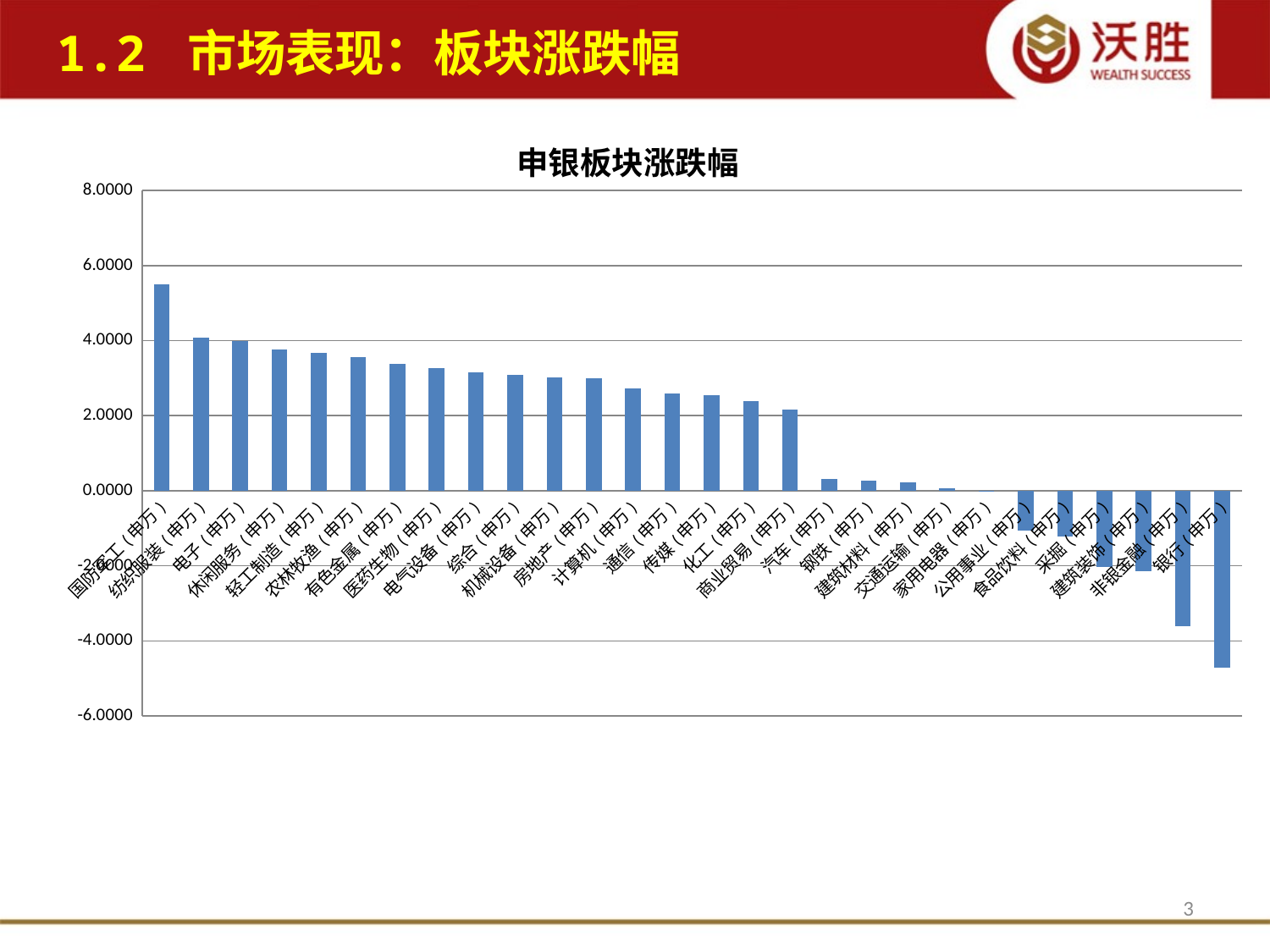
What is the title of the chart? 申银板块涨跌幅 Is the value for 国防军工（申万） greater or less than 4.0000? greater Which has the larger value, 国防军工（申万） or 纺织服装（申万）? 国防军工（申万） Which sector has the highest value in the chart? 国防军工（申万） Which sector has the lowest value in the chart? 银行（申万） Is the value for 非银金融（申万） greater or less than -2.0000? less Is the value for 休闲服务（申万） greater or less than 4.0000? less Do the values rise or fall moving from left to right along the x axis? fall How many categories (sectors) are plotted in the chart? 28 What kind of chart is shown on the slide? bar chart Which has the larger value, 银行（申万） or 非银金融（申万）? 非银金融（申万）